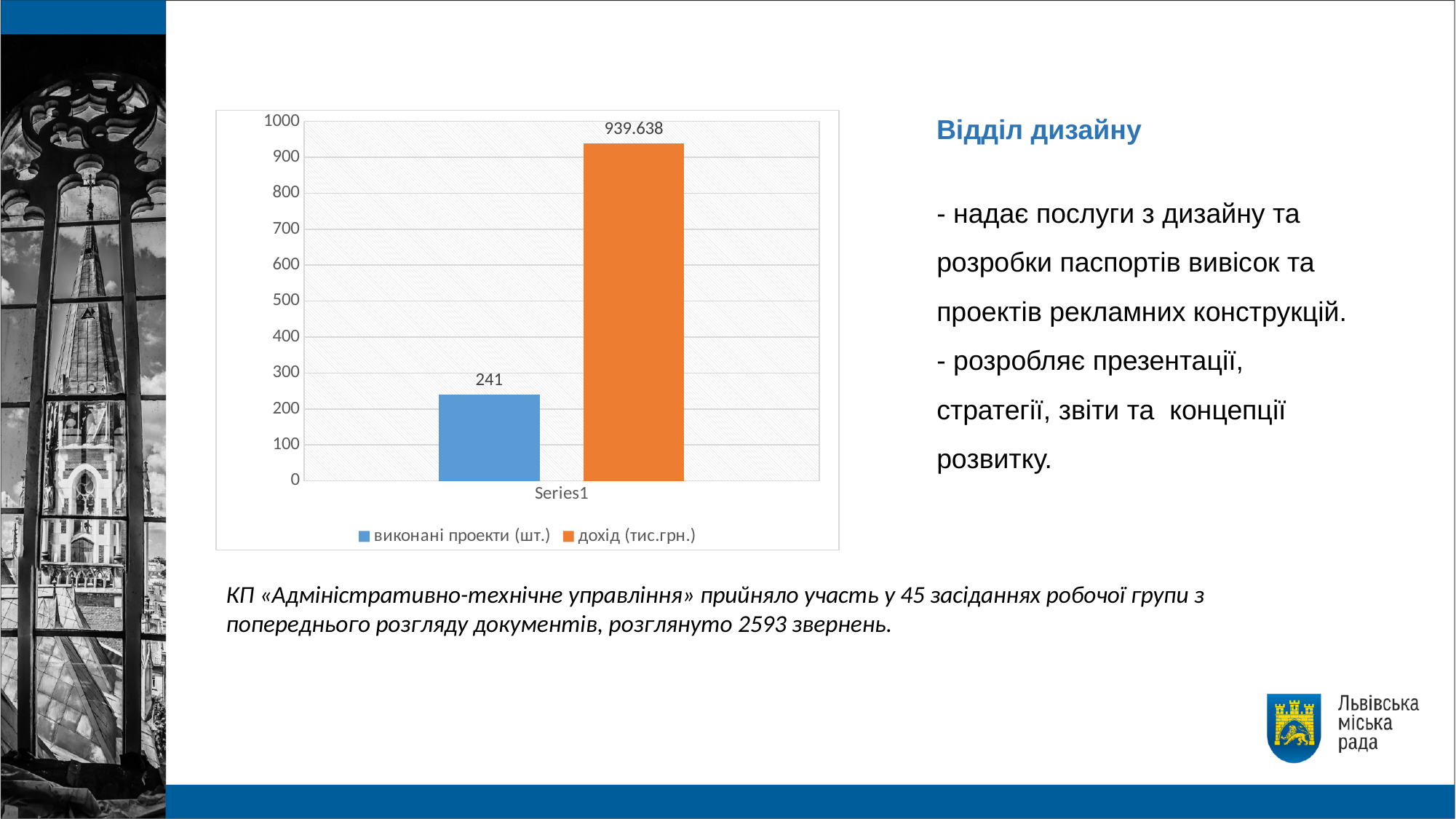
What is the value of the 'дохід (тис.грн.)' bar? 939.638 What is the value of the 'виконані проекти (шт.)' bar? 241 Which series has the highest value on the chart? дохід (тис.грн.) Is the value for 'виконані проекти (шт.)' greater or less than 300? less What kind of chart is shown on the slide? Bar chart Which series has the lowest value on the chart? виконані проекти (шт.) How many series does the legend list? 2 Which series has the higher value, 'виконані проекти (шт.)' or 'дохід (тис.грн.)'? дохід (тис.грн.) What is the difference between the 'дохід (тис.грн.)' value and the 'виконані проекти (шт.)' value? 698.638 Is the value for 'дохід (тис.грн.)' greater or less than 900? greater What colour is the 'дохід (тис.грн.)' bar? Orange What is the category label shown on the x axis? Series1